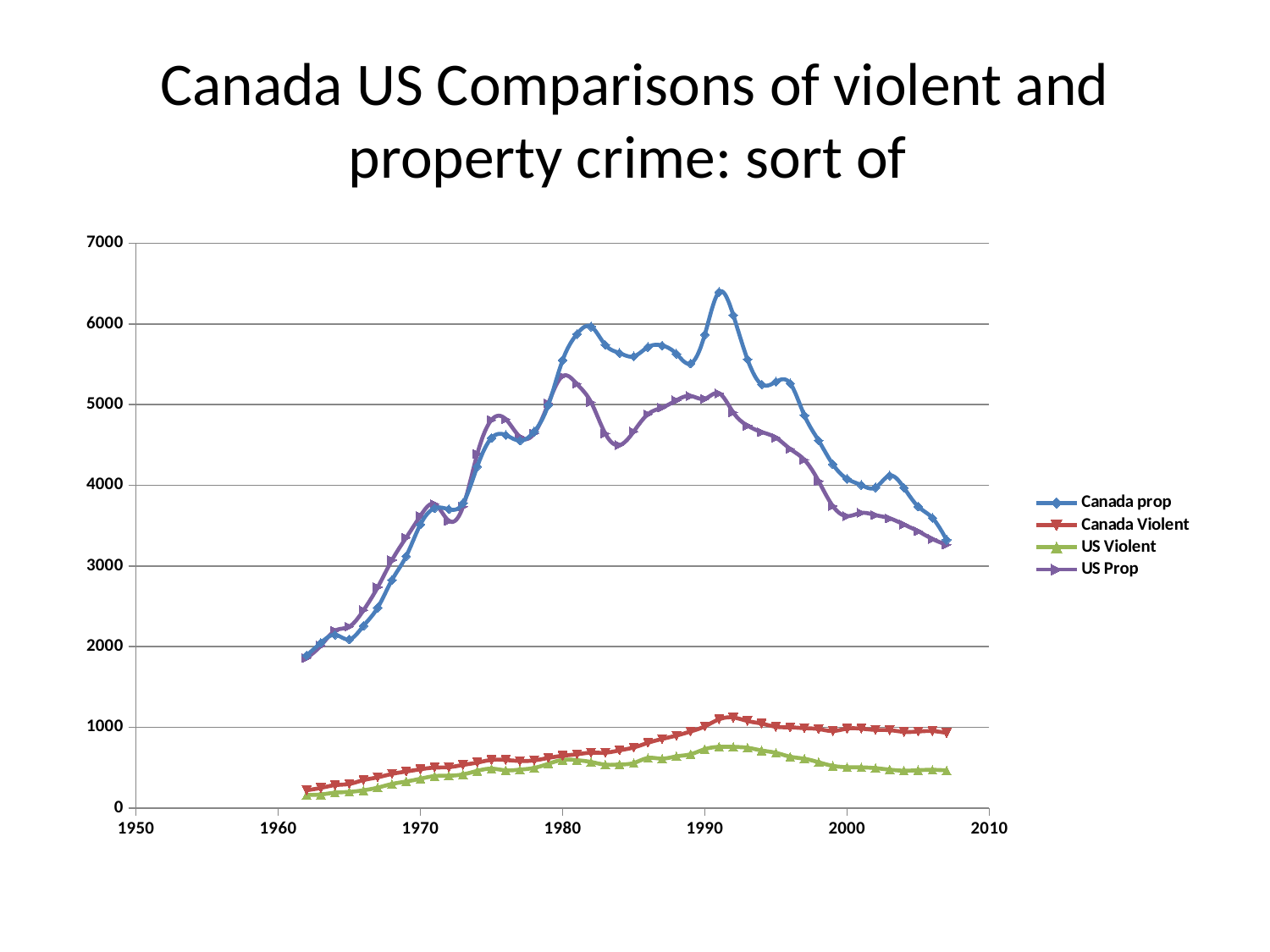
Which series has the lowest values throughout the chart? US Violent What are the series names listed in the legend? Canada prop, Canada Violent, US Violent, US Prop What is the title of the slide? Canada US Comparisons of violent and property crime: sort of Is the value of the Canada prop series in 2007 greater or less than 4000? less In 2000, which is larger: Canada prop or US Prop? Canada prop How many series does the legend list? 4 What kind of chart is shown on the slide? line chart In 2007, which is larger: Canada Violent or US Violent? Canada Violent Is the value of the US Prop series in 1980 greater or less than 5000? greater Is the peak value of the Canada prop series around 1991 greater or less than 6000? greater Which series reaches the highest value on the chart? Canada prop Does the US Prop series rise or fall between 1991 and 2007? fall